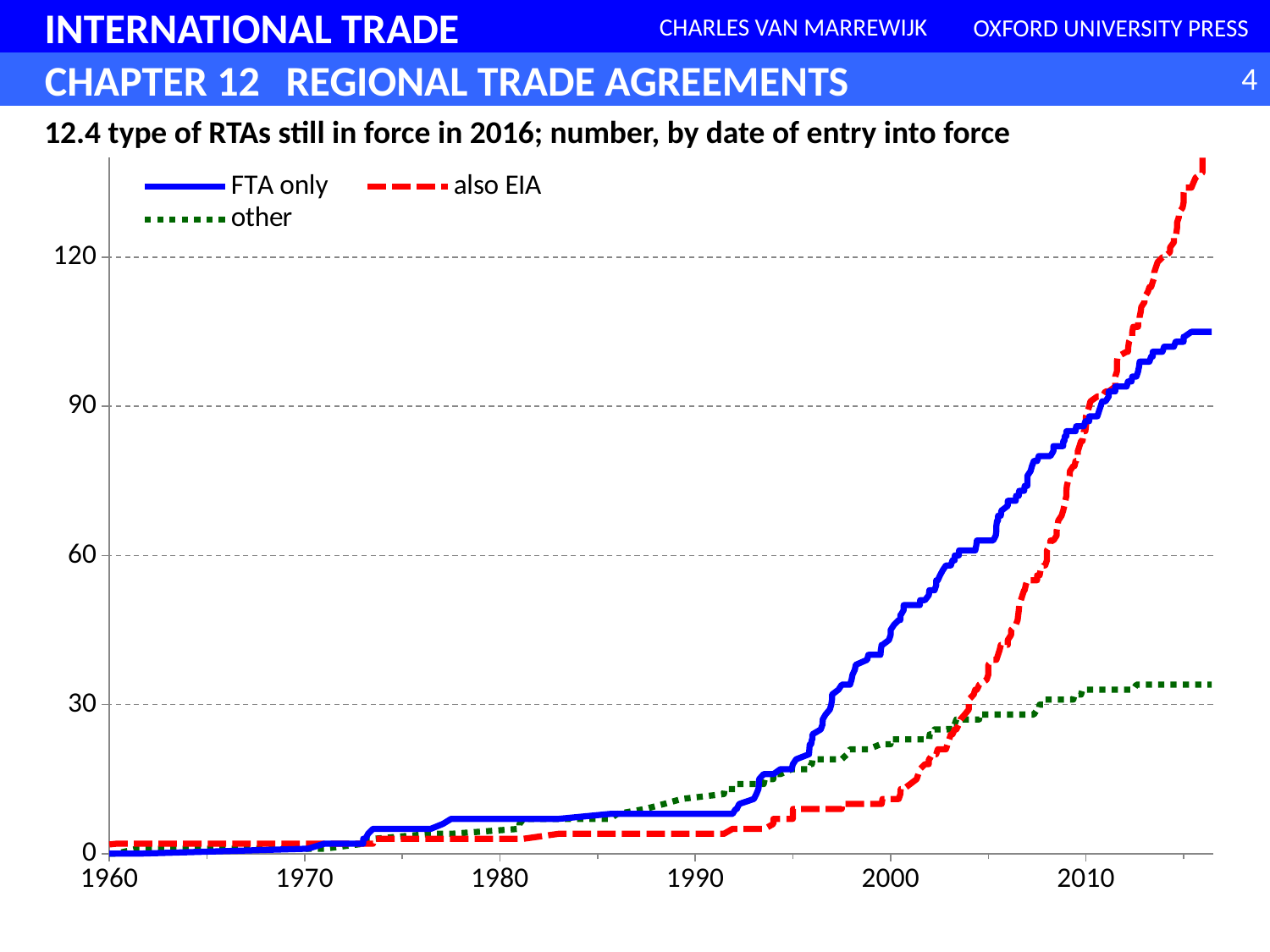
Does the 'FTA only' series rise or fall from 1960 to 2016? rise What is the title of the chart? 12.4 type of RTAs still in force in 2016; number, by date of entry into force Which series is drawn with a red dashed line? also EIA In 2000, which is larger: the value for 'FTA only' or the value for 'also EIA'? FTA only Which series has the lowest value at the right end of the chart (2016)? other How many series does the legend list? 3 Is the value for 'FTA only' at the right end of the chart (2016) greater or less than 90? greater Is the value for 'other' at the right end of the chart (2016) greater or less than 30? greater Is the value for 'also EIA' at the right end of the chart (2016) greater or less than 120? greater Which series has the highest value at the right end of the chart (2016)? also EIA What kind of chart is shown on the slide? line chart